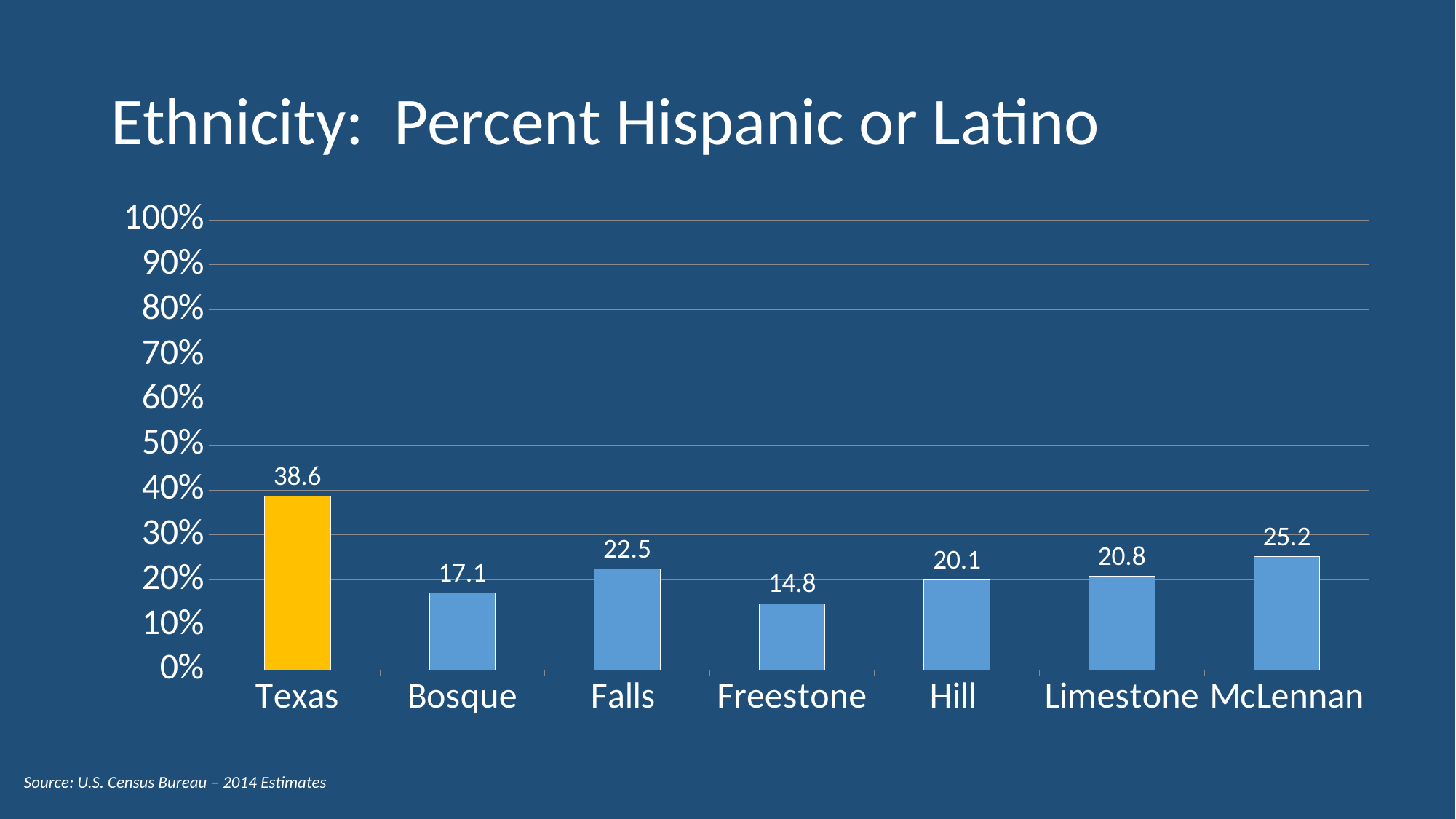
Which category has the lowest value? Freestone What kind of chart is shown on the slide? Bar chart Which has a larger value, Falls or Bosque? Falls What is the value shown for Texas? 38.6 Which bar is coloured differently from the others? Texas How many categories are shown on the x axis? 7 What is the value shown for McLennan? 25.2 What is the difference between the values for Limestone and Hill? 0.7 Which category has the highest value? Texas What is the difference between the values for Texas and McLennan? 13.4 What is the value shown for Freestone? 14.8 Is the value for Texas greater or less than 30%? greater